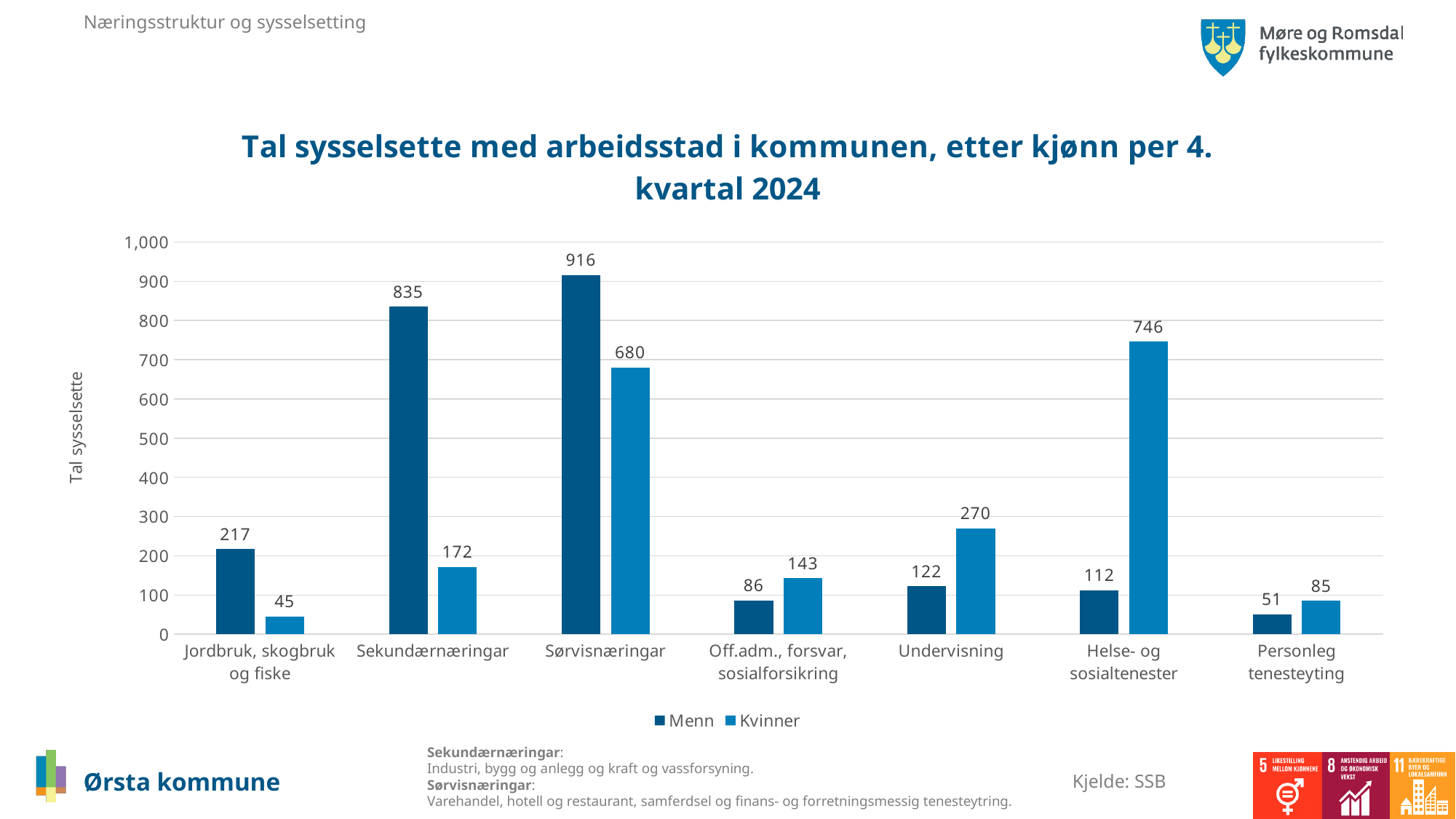
What is the label of the y axis? Tal sysselsette What kind of chart is shown? Bar chart Is the value for Kvinner in Sørvisnæringar greater or less than 600? greater What is the value for Menn in Sørvisnæringar? 916 Which is larger in Undervisning, Menn or Kvinner? Kvinner How many categories are shown on the x axis? 7 What is the value for Kvinner in Jordbruk, skogbruk og fiske? 45 Which category has the lowest value for Kvinner? Jordbruk, skogbruk og fiske Which category has the highest value for Menn? Sørvisnæringar What is the value for Kvinner in Helse- og sosialtenester? 746 What is the difference between Menn and Kvinner in Sekundærnæringar? 663 How many series does the legend list? 2